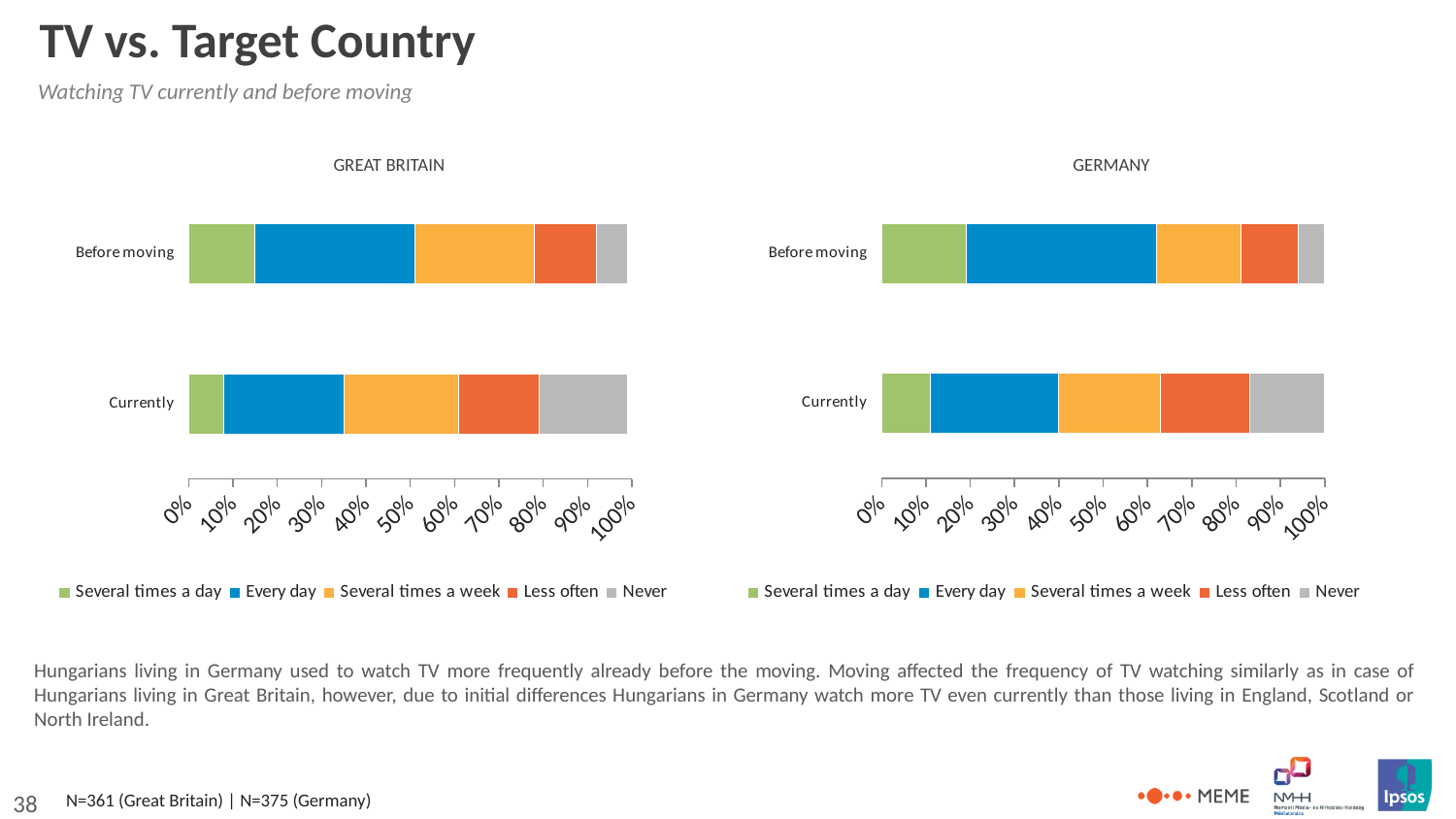
What colour represents the 'Never' series in the legends? Grey How many categories are shown on the y axis of the Great Britain chart? 2 In the Great Britain chart, is the 'Several times a day' share for 'Currently' greater or less than 20%? less What kind of chart is used for Great Britain on this slide? Stacked bar chart In the Great Britain chart, which series has the largest segment in the 'Before moving' bar? Every day In the Germany chart, is the 'Never' segment larger for 'Before moving' or for 'Currently'? Currently In the Great Britain chart, is the 'Every day' share for 'Before moving' greater or less than 30%? greater In the Germany chart, is the 'Never' share for 'Before moving' greater or less than 10%? less In the Germany chart, which series has the largest segment in the 'Before moving' bar? Every day In the Great Britain chart, is the 'Every day' segment larger for 'Before moving' or for 'Currently'? Before moving How many series does the legend of the Germany chart list? 5